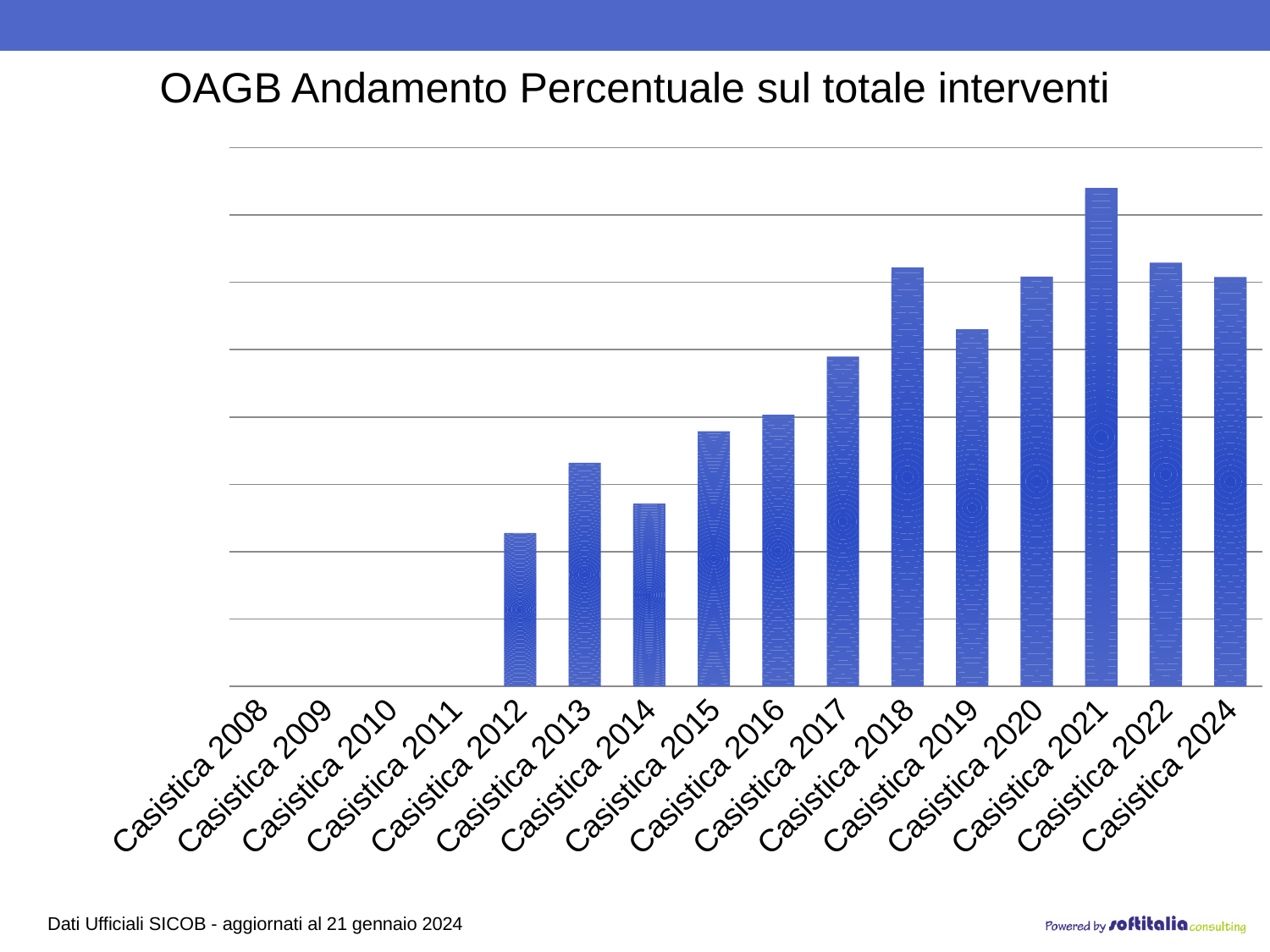
Which is higher, the bar for Casistica 2016 or Casistica 2017? Casistica 2017 Which is higher, the bar for Casistica 2018 or Casistica 2019? Casistica 2018 Which category has the highest bar? Casistica 2021 How many categories have no visible bar? 4 Which is higher, the bar for Casistica 2013 or Casistica 2014? Casistica 2013 Which is the first category on the x axis with a visible bar? Casistica 2012 What is the title of the chart? OAGB Andamento Percentuale sul totale interventi What kind of chart is shown on the slide? bar chart Which category has the lowest visible bar? Casistica 2012 Do the bars generally rise or fall from Casistica 2014 to Casistica 2018? rise How many categories are shown on the x axis? 16